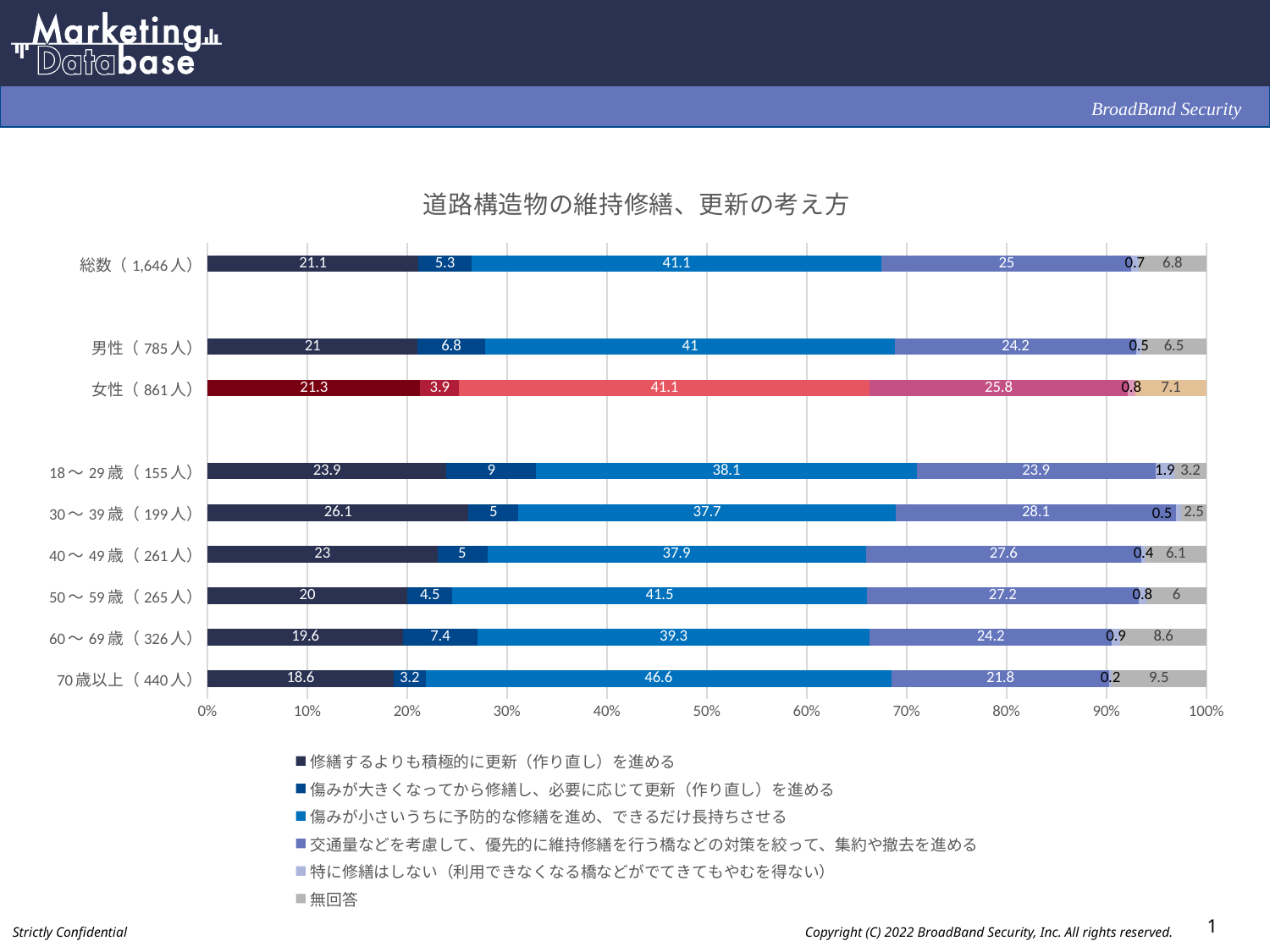
Which category has the highest value for 「傷みが小さいうちに予防的な修繕を進め、できるだけ長持ちさせる」? 70歳以上（440人） What is the difference between 男性（785人） and 女性（861人） for 「傷みが大きくなってから修繕し、必要に応じて更新（作り直し）を進める」? 2.9 Which is larger for 「交通量などを考慮して、優先的に維持修繕を行う橋などの対策を絞って、集約や撤去を進める」: 30～39歳（199人） or 70歳以上（440人）? 30～39歳（199人） Which category has the lowest value for 「修繕するよりも積極的に更新（作り直し）を進める」? 70歳以上（440人） What is the value of 「傷みが小さいうちに予防的な修繕を進め、できるだけ長持ちさせる」 for 総数（1,646人）? 41.1 What is the total of all segments in the 18～29歳（155人） bar? 100 What is the title of the chart? 道路構造物の維持修繕、更新の考え方 How many categories (rows) are plotted in the chart? 9 How many series does the legend list? 6 What type of chart is shown on the slide? Stacked bar chart What is the value of 「無回答」 for 70歳以上（440人）? 9.5 What is the value of 「修繕するよりも積極的に更新（作り直し）を進める」 for 30～39歳（199人）? 26.1